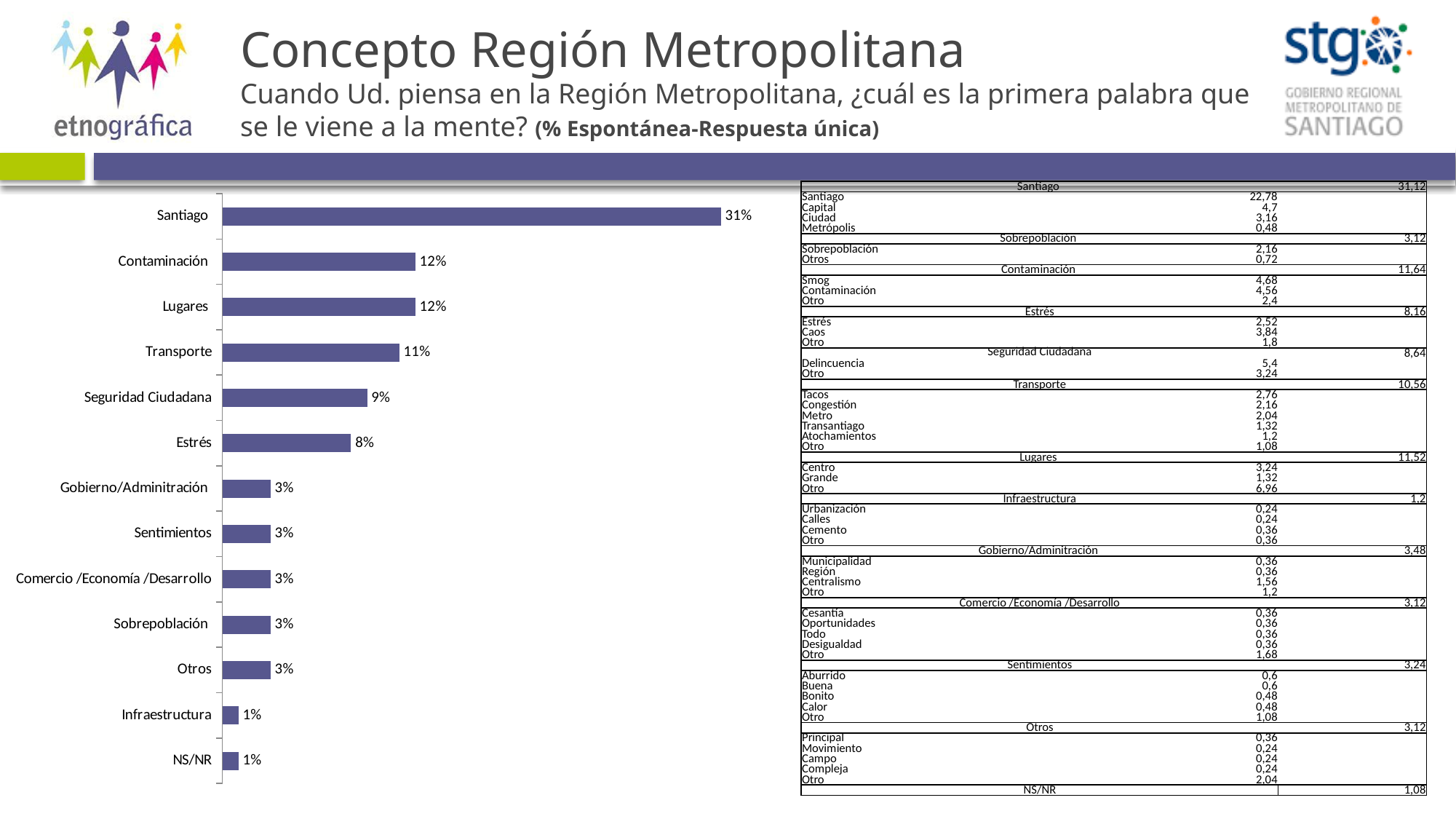
What is the value for Seguridad Ciudadana in the bar chart? 9% What kind of chart is shown on the slide? bar chart Which category has the highest value in the bar chart? Santiago What is the value for Estrés in the bar chart? 8% What is the value for Santiago in the bar chart? 31% How many categories are shown in the bar chart? 13 What is the difference between the values for Santiago and Transporte in the bar chart? 20% Which is larger in the bar chart, the value for Transporte or the value for Estrés? Transporte What is the value for Transporte in the bar chart? 11% Which is larger in the bar chart, the value for Seguridad Ciudadana or the value for Sobrepoblación? Seguridad Ciudadana What is the value for Infraestructura in the bar chart? 1% What is the difference between the values for Contaminación and Estrés in the bar chart? 4%